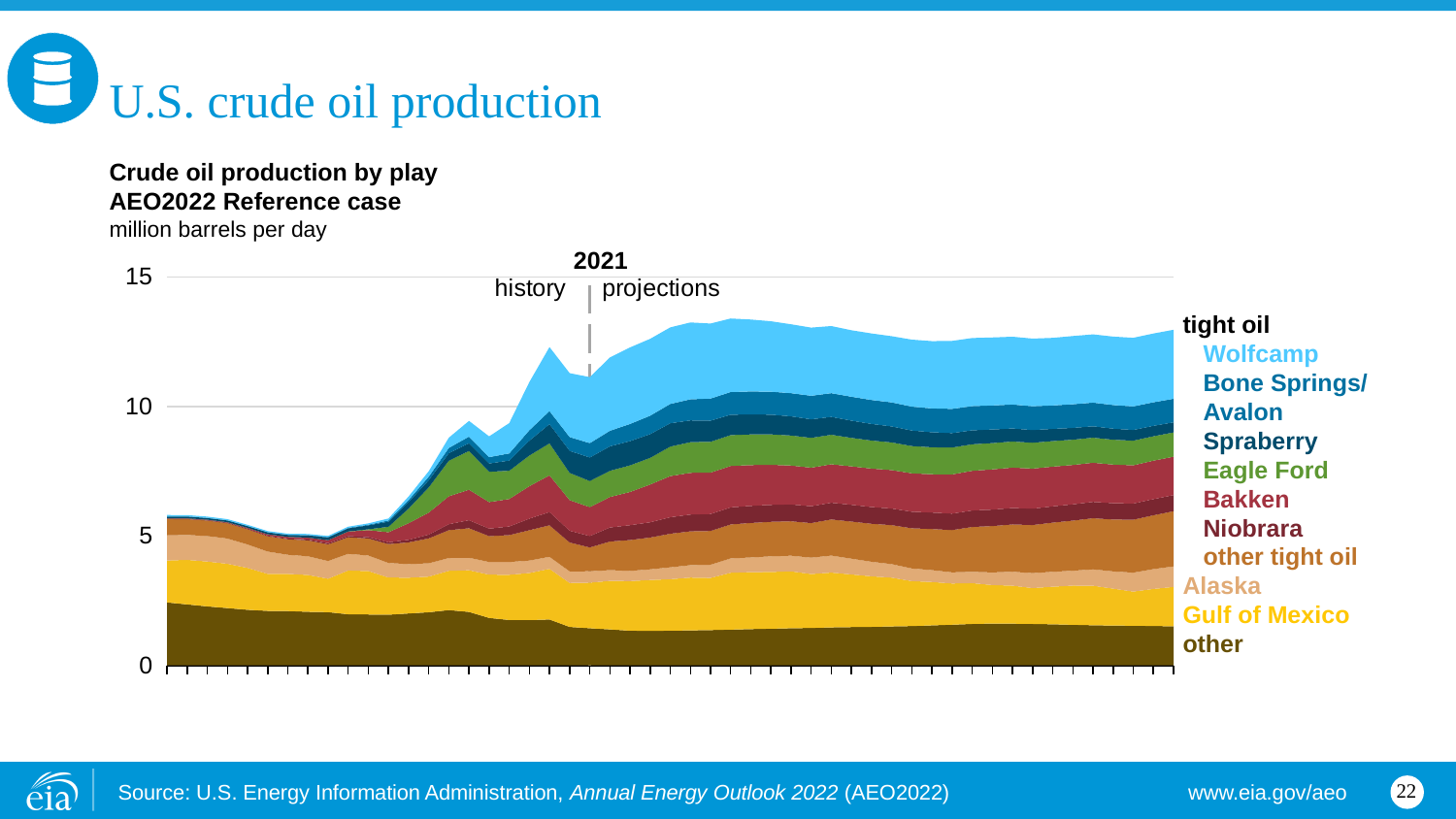
In the projection period, which contributes more production, Gulf of Mexico or Alaska? Gulf of Mexico In the projection period, which contributes more production, Wolfcamp or Alaska? Wolfcamp Does total crude oil production rise or fall from the start of the history period to the end of the projection period? rise Is total crude oil production in 2021 greater or less than 10 million barrels per day? greater What kind of chart is shown on the slide? stacked area chart Is total U.S. crude oil production at the start of the history period greater or less than 10 million barrels per day? less How many series does the legend list? 10 Which tight oil play contributes the most production in the projection period? Wolfcamp Which year separates history from projections in the chart? 2021 Is total U.S. crude oil production at the end of the projection period greater or less than 10 million barrels per day? greater What is the unit of measurement shown for the chart? million barrels per day